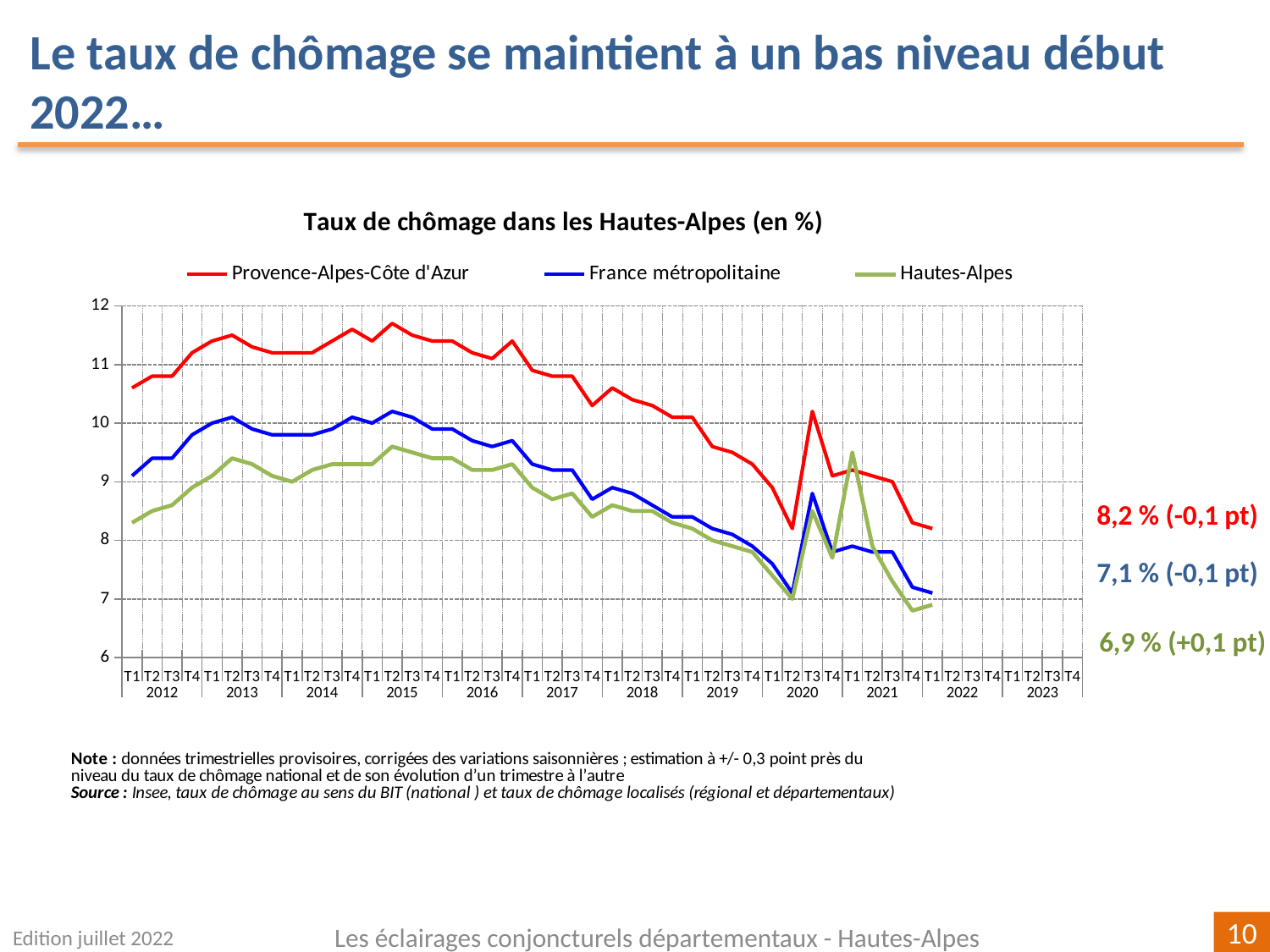
Is the value for Provence-Alpes-Côte d'Azur in T2 2015 greater or less than 11? greater What is the latest unemployment rate shown for Hautes-Alpes? 6,9 % What is the difference between the latest values for Provence-Alpes-Côte d'Azur and France métropolitaine? 1,1 Does the Hautes-Alpes series rise or fall between 2016 and 2019? fall What kind of chart is shown on the slide? line chart Is the value for Hautes-Alpes in T2 2020 greater or less than 8? less What is the latest unemployment rate shown for Provence-Alpes-Côte d'Azur? 8,2 % At T1 2022, which is higher: Provence-Alpes-Côte d'Azur or Hautes-Alpes? Provence-Alpes-Côte d'Azur Which series has the lowest value at the end of the chart (T1 2022)? Hautes-Alpes What is the latest unemployment rate shown for France métropolitaine? 7,1 % How many series does the legend list? 3 What quarterly change is annotated for the Hautes-Alpes series? +0,1 pt